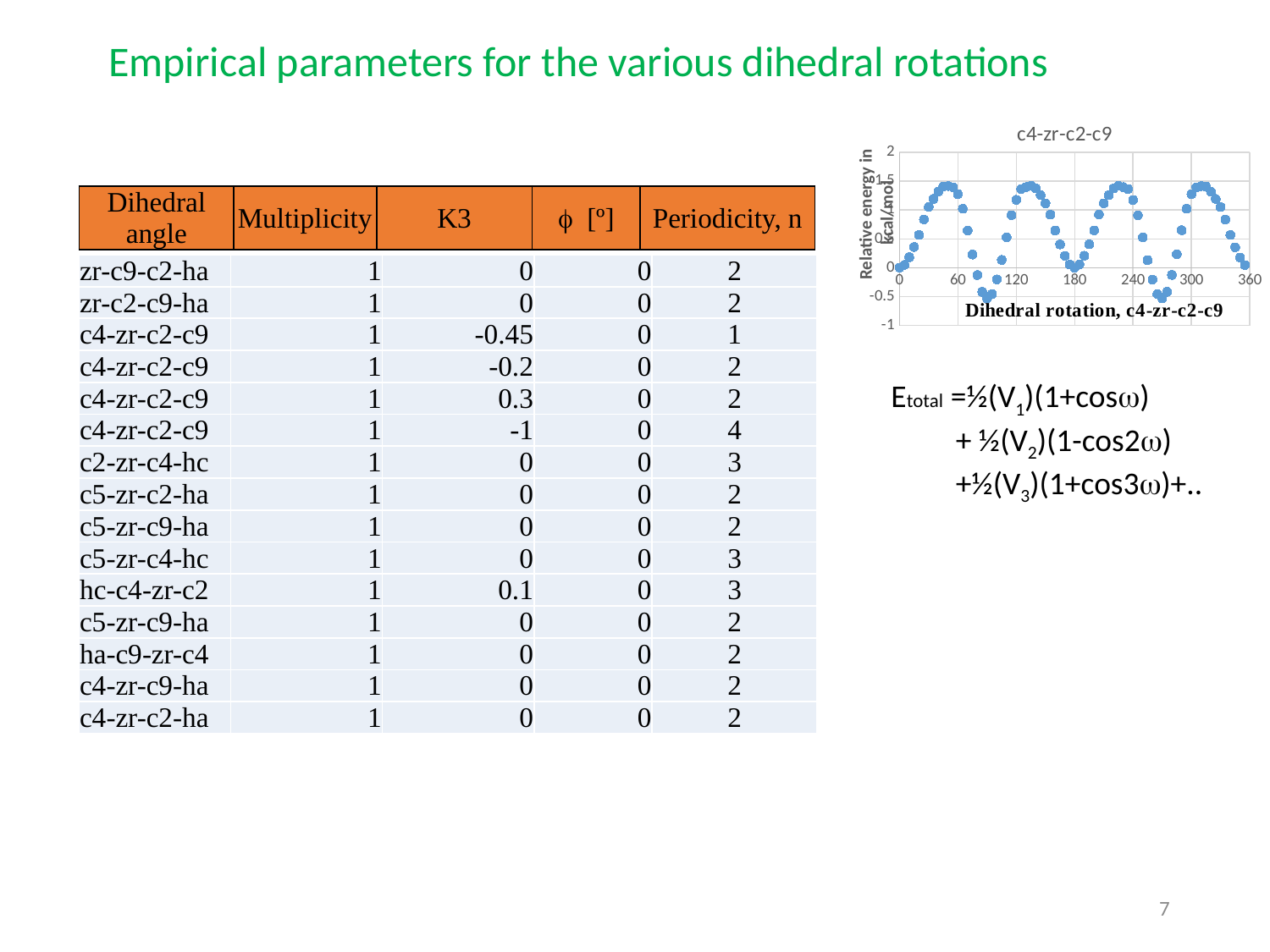
What is the largest value shown on the x axis of the chart? 360 How many peaks (maxima) does the plotted curve show between 0 and 360 degrees? 4 How many data series are plotted in the chart? 1 In the chart, is the relative energy at a dihedral rotation of 270 greater or less than 0? less What is the title of the chart on the slide? c4-zr-c2-c9 In the chart, is the relative energy at a dihedral rotation of 90 greater or less than 1? less In the chart, is the relative energy near a dihedral rotation of 135 greater or less than 0.5? greater What is the x-axis label of the chart? Dihedral rotation, c4-zr-c2-c9 What kind of chart is shown on the slide? scatter chart In the chart, does the relative energy rise or fall as the dihedral rotation goes from 0 to 45 degrees? rise